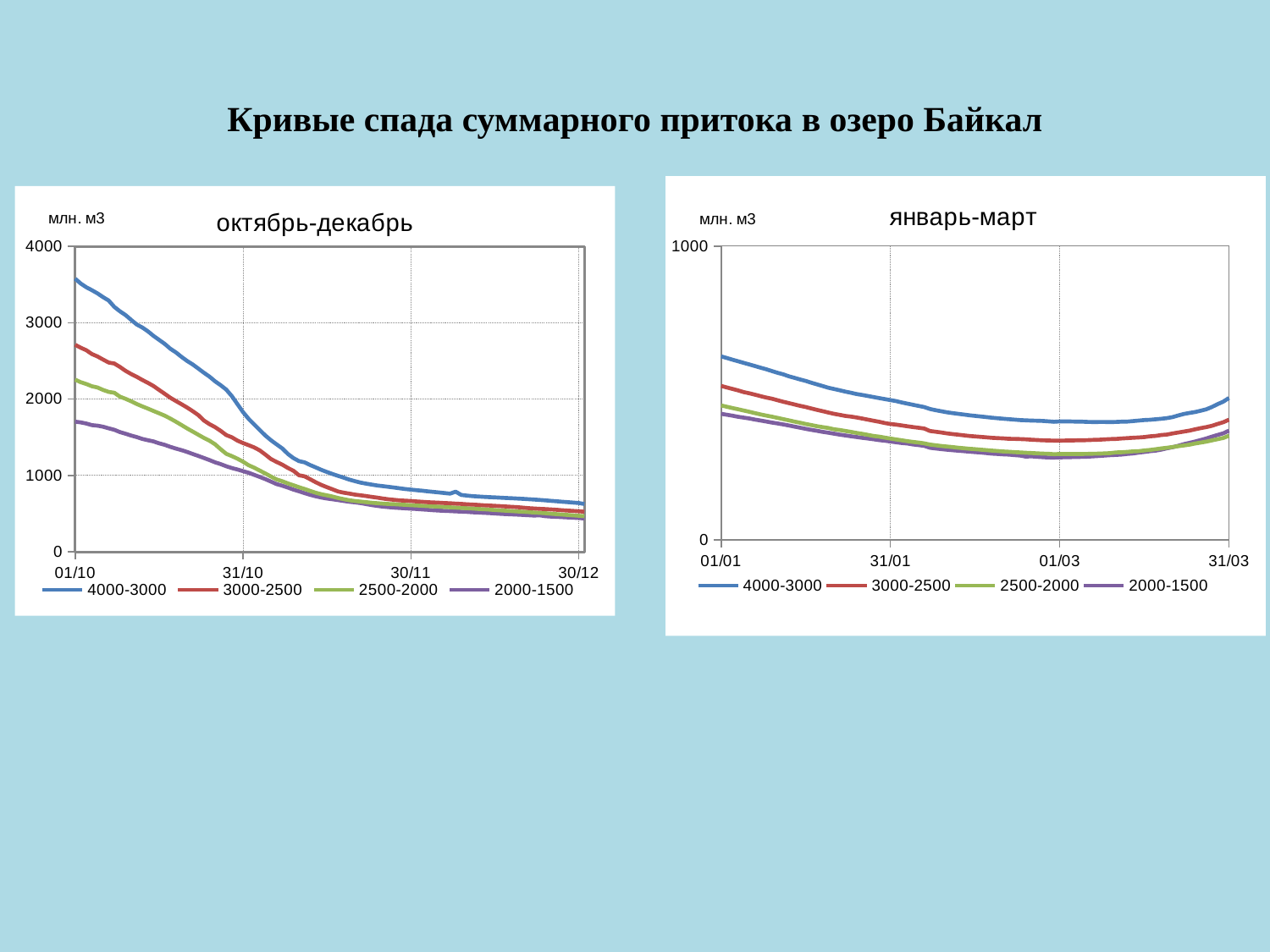
How many series does the legend of the "январь-март" chart list? 4 What kind of chart is the "октябрь-декабрь" chart on the left? line chart What is the title of the chart on the right? январь-март In the "январь-март" chart, which series has the higher value at 01/01: 4000-3000 or 2500-2000? 4000-3000 In the "январь-март" chart, does the 4000-3000 series rise or fall from 01/01 to 01/03? fall In the "октябрь-декабрь" chart, is the value of the 2000-1500 series at 01/10 greater or less than 2000? less What unit is shown on the y axis of the "октябрь-декабрь" chart? млн. м3 In the "октябрь-декабрь" chart, which series has the higher value at 01/10: 4000-3000 or 2000-1500? 4000-3000 In the "октябрь-декабрь" chart, is the value of the 4000-3000 series at 01/10 greater or less than 3000? greater In the "октябрь-декабрь" chart, is the value of the 4000-3000 series at 30/12 greater or less than 1000? less In the "октябрь-декабрь" chart, does the 4000-3000 series rise or fall from 01/10 to 30/12? fall